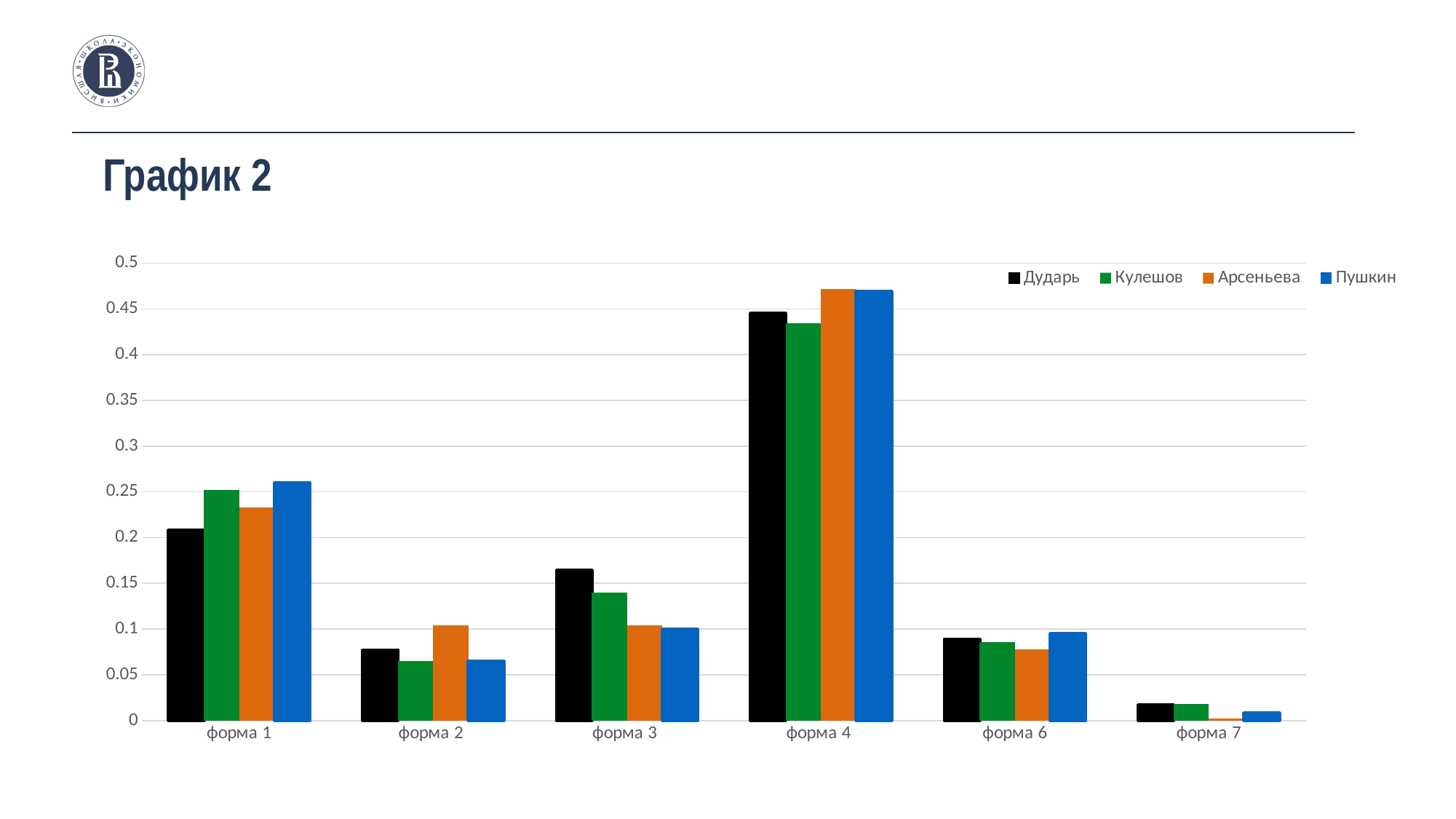
Is the value for Арсеньева in форма 4 greater or less than 0.45? greater In форма 3, which is larger: the value for Дударь or the value for Кулешов? Дударь What is the title of the slide? График 2 Which category has the lowest value for the Пушкин series? форма 7 How many categories are shown on the x axis? 6 Which category has the highest value for the Дударь series? форма 4 In форма 1, which is larger: the value for Пушкин or the value for Дударь? Пушкин Is the value for Кулешов in форма 4 greater or less than 0.45? less Is the value for Дударь in форма 1 greater or less than 0.2? greater How many series does the legend list? 4 What kind of chart is shown on the slide? bar chart